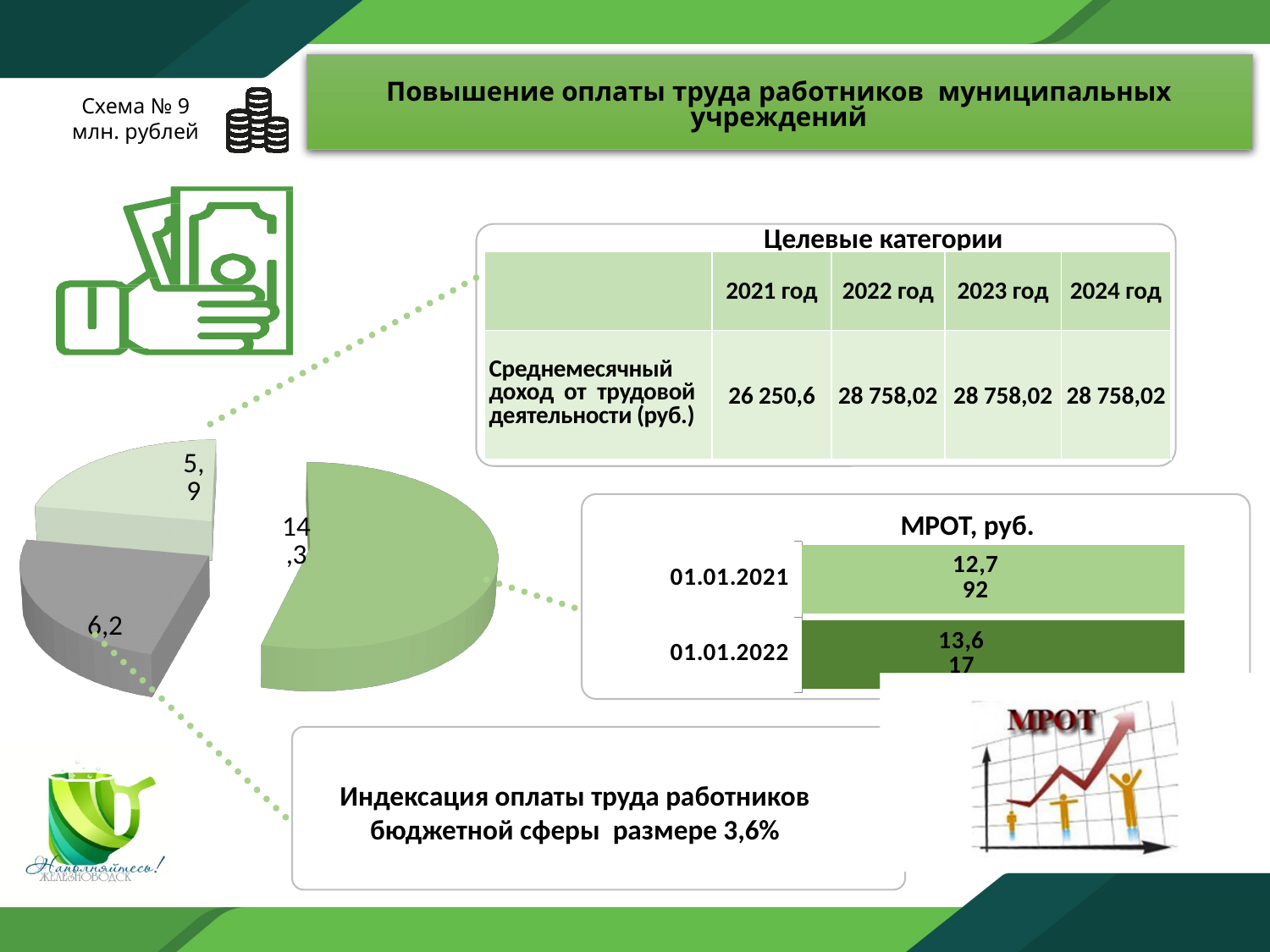
In the 'МРОТ, руб.' chart, what is the value for 01.01.2021? 12,792 In the pie chart on the left, which slice is larger: the gray slice or the light green slice? the gray slice (6,2) In the 'МРОТ, руб.' chart, how many categories are shown? 2 How many slices does the pie chart on the left have? 3 In the pie chart on the left, what is the total of all three slices? 26,4 In the pie chart on the left, what is the value of the smallest slice? 5,9 What kind of chart is the 'МРОТ, руб.' chart? bar chart What kind of chart is the chart on the left side of the slide? pie chart In the pie chart on the left, what is the value of the largest slice? 14,3 In the pie chart on the left, what is the difference between the largest slice (14,3) and the gray slice (6,2)? 8,1 In the 'МРОТ, руб.' chart, which date has the higher value? 01.01.2022 In the 'МРОТ, руб.' chart, what is the value for 01.01.2022? 13,617